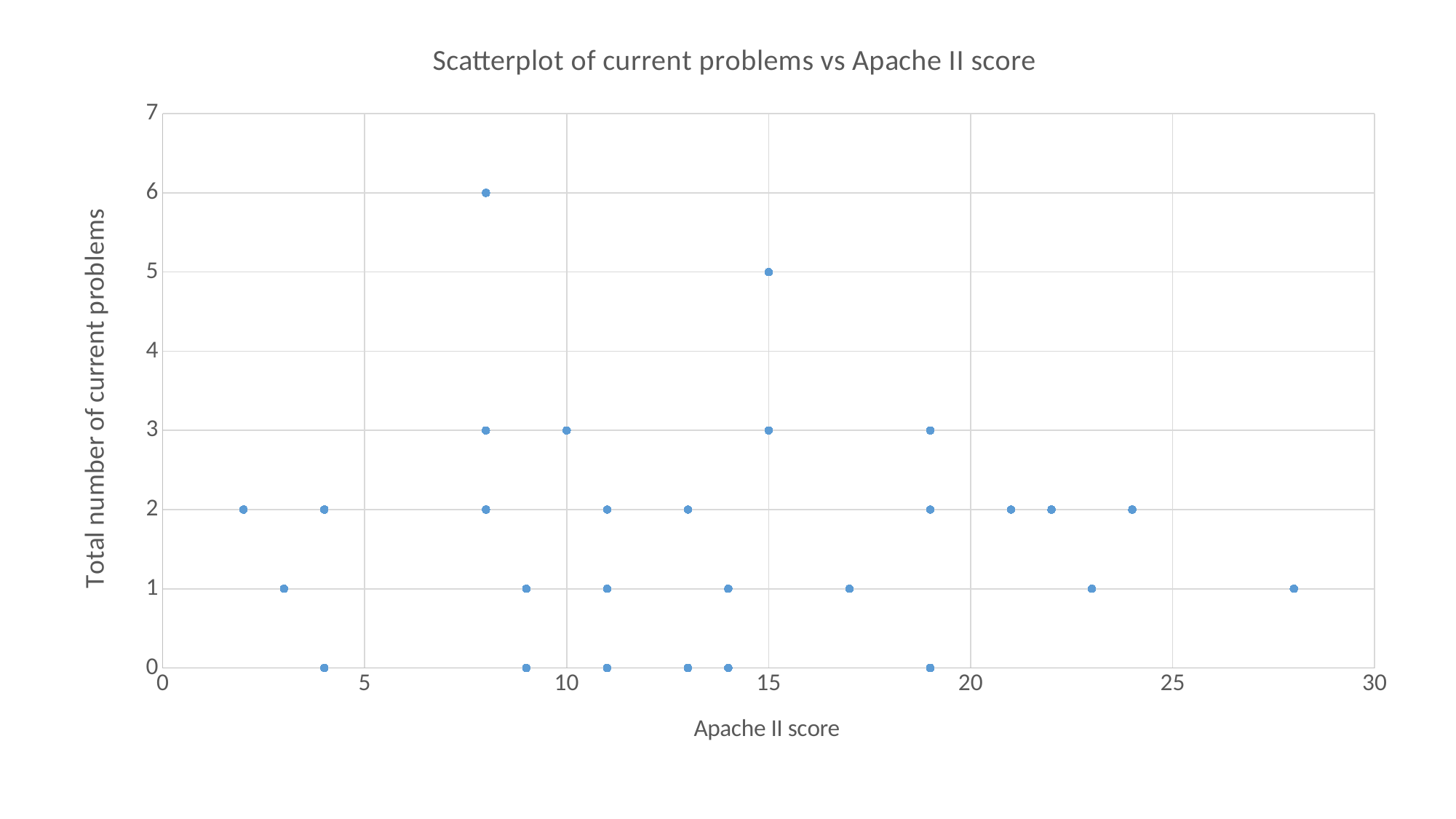
How many points have a total of 5 current problems? 1 Does the point with 6 current problems have a higher or lower Apache II score than the point with 5 current problems? lower Is the Apache II score of the rightmost point greater or less than 25? greater What is the label of the vertical axis? Total number of current problems What is the highest total number of current problems plotted for any point? 6 Is the Apache II score of the point with 6 current problems greater or less than 10? less What kind of chart is shown on the slide? Scatter plot What is the total number of current problems for the point with the highest Apache II score? 1 What is the title of the chart? Scatterplot of current problems vs Apache II score How many points have a total of 3 current problems? 4 What is the Apache II score of the point with 5 current problems? 15 What is the total number of current problems for the point at an Apache II score of 10? 3